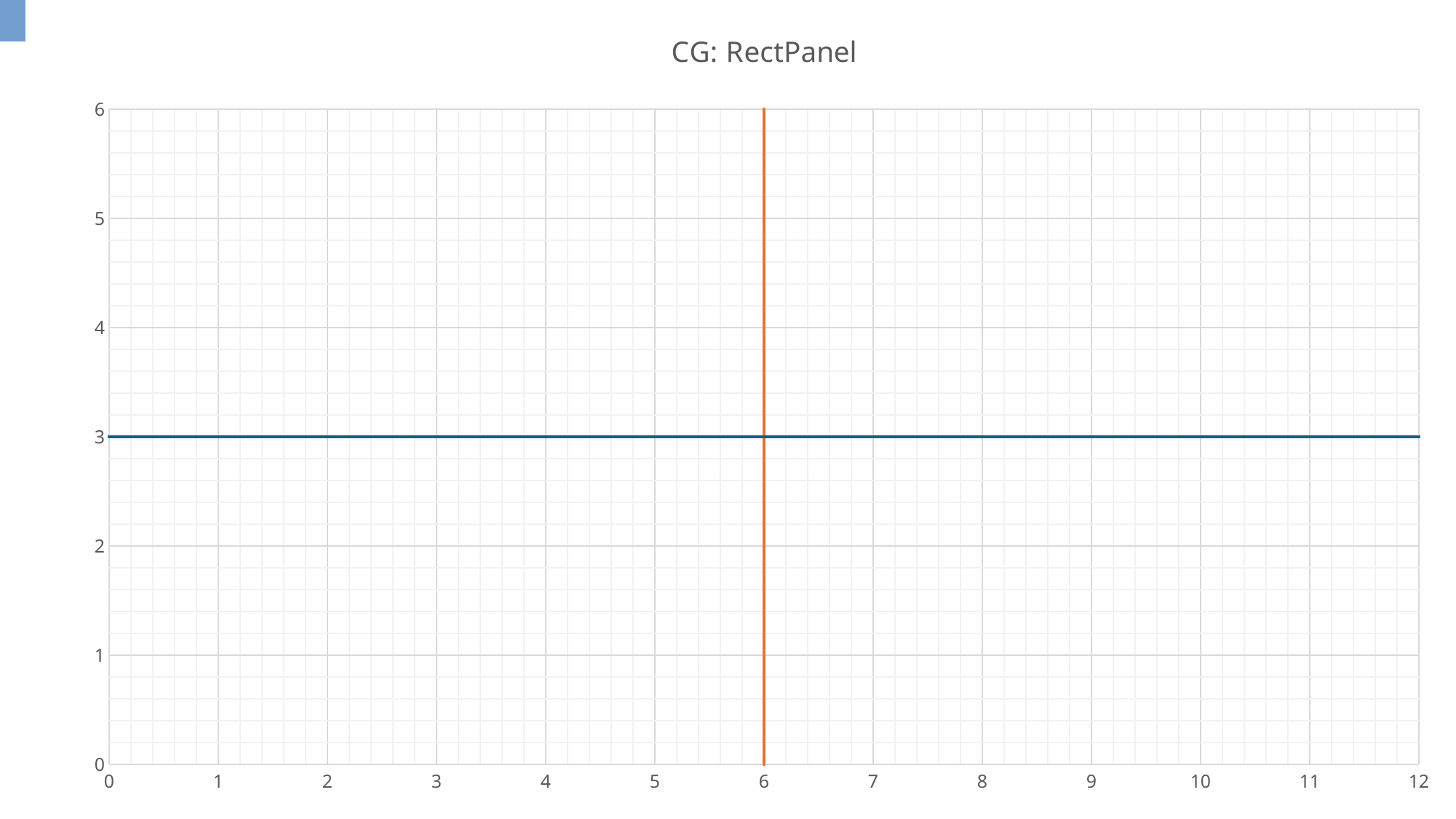
What kind of chart is shown on the slide? line chart At what x-axis value does the vertical orange line sit? 6 At what y-axis value does the horizontal blue line sit? 3 Does the horizontal blue line rise, fall, or stay flat as x increases from 0 to 12? stays flat Is the vertical orange line to the right or left of x = 5? right What is the highest value shown on the x axis? 12 How many labelled tick marks are there on the x axis? 13 What is the highest value shown on the y axis? 6 How many lines are plotted on the chart? 2 What is the title of the chart? CG: RectPanel What colour is the vertical line on the chart? orange Is the horizontal blue line above or below the y-axis value 4? below